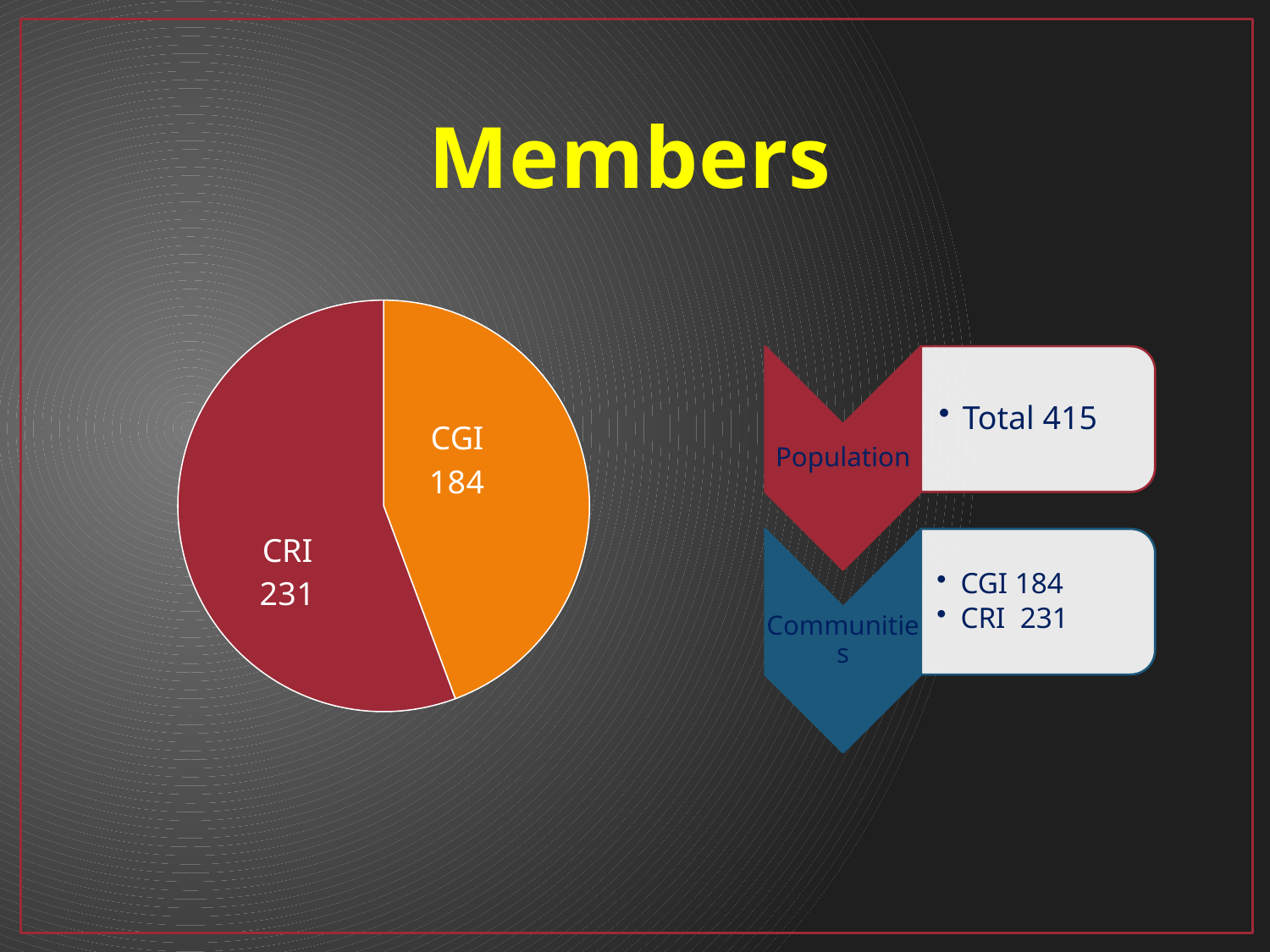
What is the title of the slide containing the pie chart? Members How many slices does the pie chart have? 2 Which is larger in the pie chart, CGI or CRI? CRI What share of the pie chart does CRI represent? 55.7% What is the value for CGI in the pie chart? 184 What colour is the CGI slice in the pie chart? orange Which slice of the pie chart is the largest? CRI What type of chart is shown on the slide? pie chart Which slice of the pie chart is the smallest? CGI What is the total of the two slices in the pie chart? 415 What is the difference between the CRI and CGI values in the pie chart? 47 What is the value for CRI in the pie chart? 231